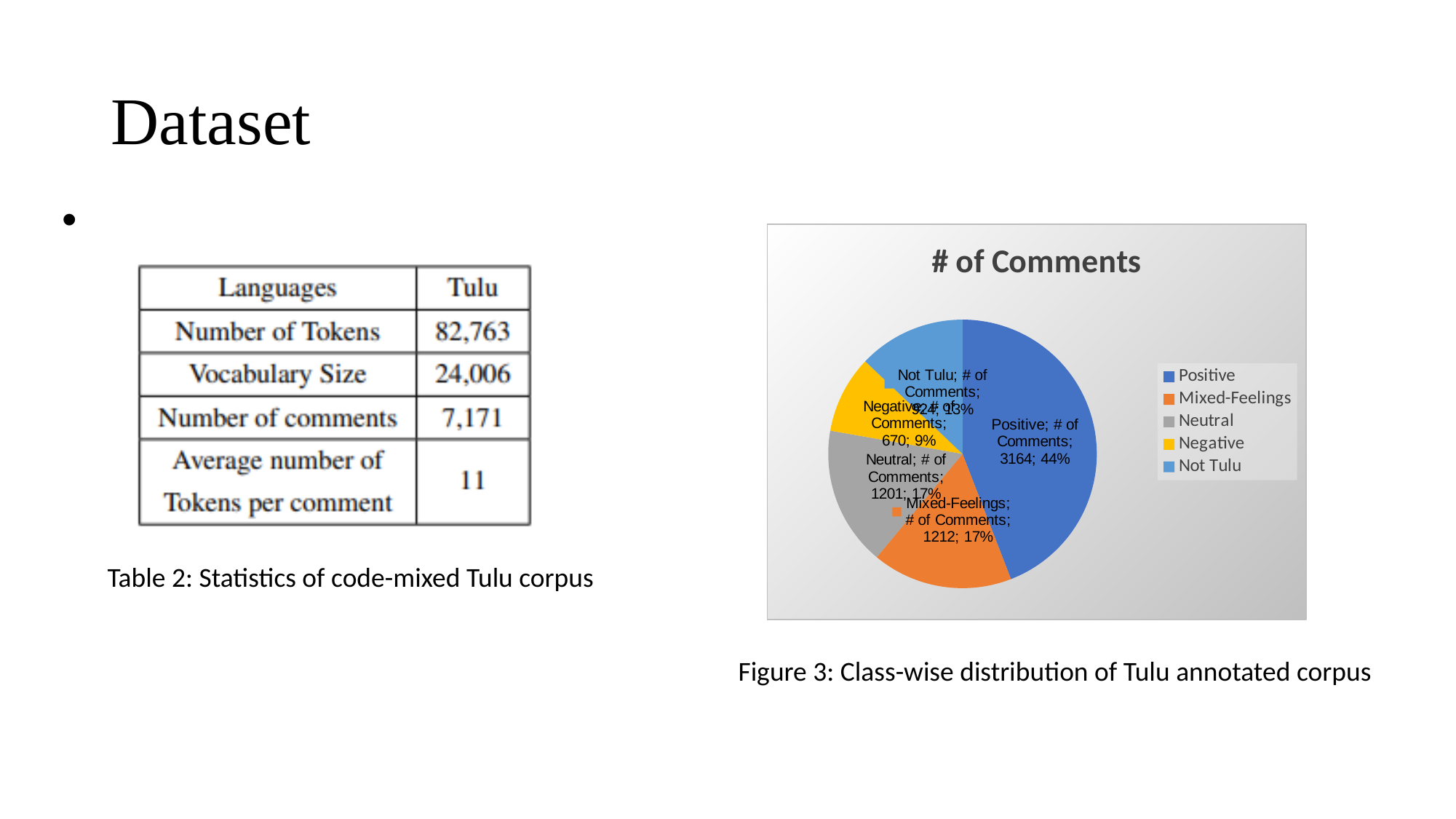
In the '# of Comments' pie chart, how many more comments are Positive than Negative? 2494 Which class has the smallest slice in the '# of Comments' pie chart? Negative How many classes are shown in the '# of Comments' pie chart? 5 How many comments are in the Mixed-Feelings class in the '# of Comments' pie chart? 1212 What share of the '# of Comments' pie does the Not Tulu class take? 13% How many comments are in the Positive class in the '# of Comments' pie chart? 3164 What share of the '# of Comments' pie does the Positive class take? 44% How many comments are in the Neutral class in the '# of Comments' pie chart? 1201 Which colour represents the Negative class in the '# of Comments' pie chart? yellow Which class has the largest slice in the '# of Comments' pie chart? Positive How many comments are in the Negative class in the '# of Comments' pie chart? 670 What kind of chart is shown in Figure 3? pie chart